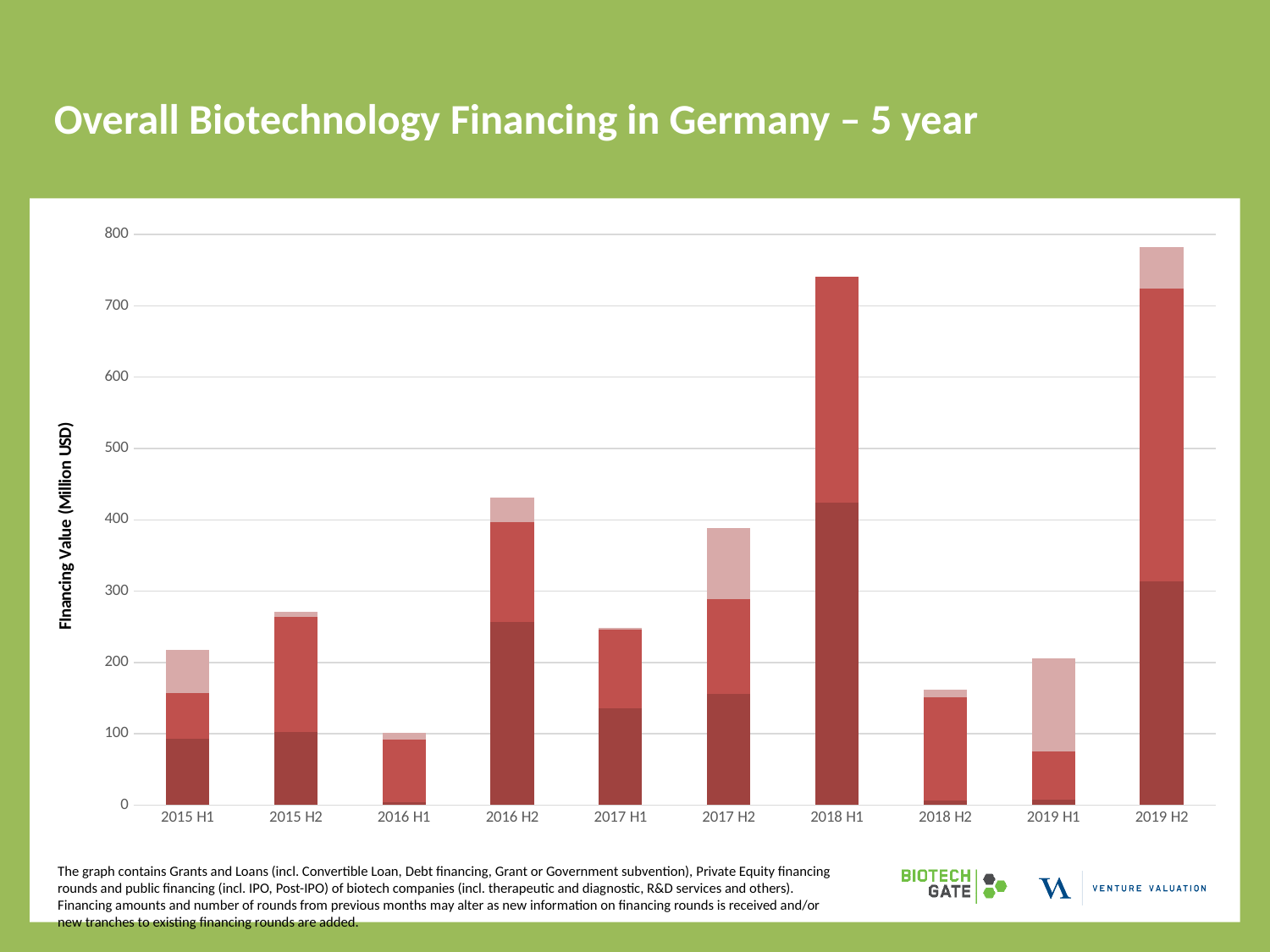
How many half-year periods are shown on the x axis? 10 Is the total financing value for 2019 H1 greater or less than 100? greater What is the label of the vertical axis? Financing Value (Million USD) What kind of chart is shown on the slide? Bar chart Which period has the highest total financing value? 2019 H2 Is the total financing value for 2016 H1 greater or less than 200? less Which period has a larger total financing value, 2018 H1 or 2018 H2? 2018 H1 From 2018 H2 to 2019 H2, do the total financing values rise or fall? rise Is the total financing value for 2018 H2 greater or less than 200? less Which period has the lowest total financing value? 2016 H1